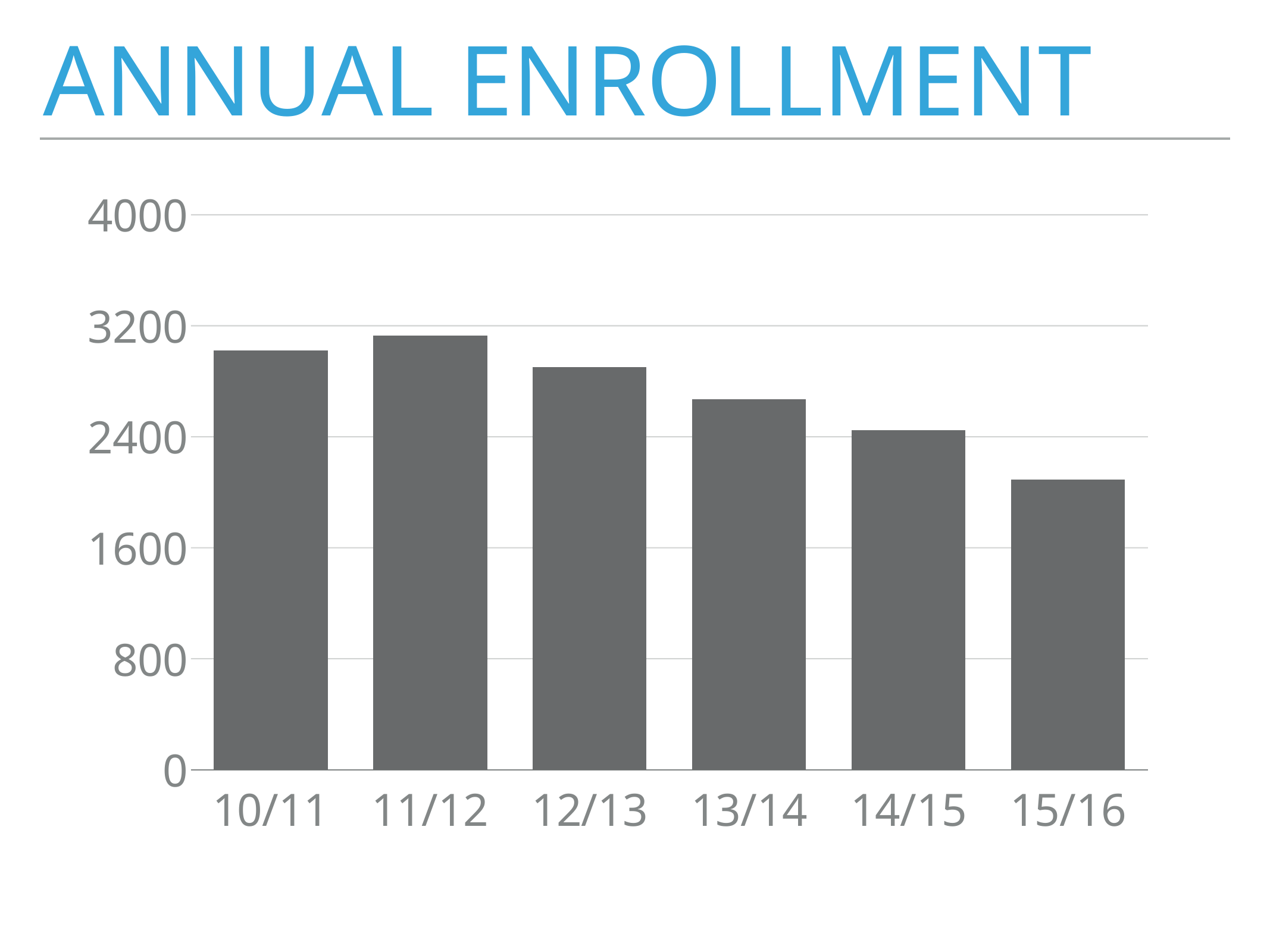
Is the value for 11/12 greater or less than 3200? less Is the value for 10/11 greater or less than 2400? greater What is the title of the chart? ANNUAL ENROLLMENT Is the value for 13/14 greater or less than 2400? greater Which is larger, the enrollment for 12/13 or for 13/14? 12/13 Which year has the lowest enrollment? 15/16 Do the enrollment values generally rise or fall from 11/12 to 15/16? fall How many academic years are shown on the x axis? 6 Which is larger, the enrollment for 10/11 or for 15/16? 10/11 What kind of chart is shown on the slide? bar chart Which year has the highest enrollment? 11/12